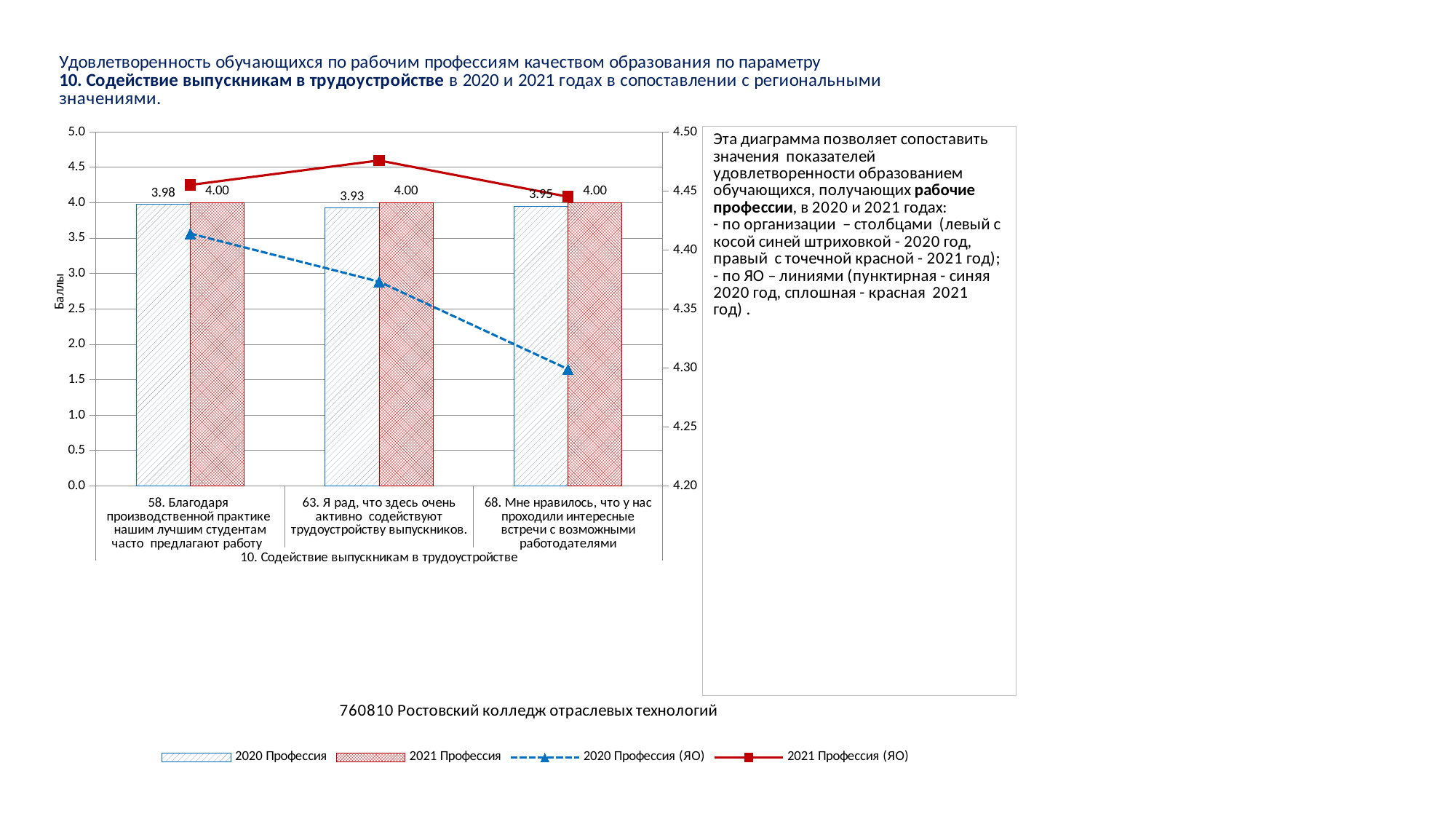
Which category has the lowest 2020 Профессия bar value? 63. Я рад, что здесь очень активно содействуют трудоустройству выпускников. What is the value of the 2021 Профессия bar for category 68 (Мне нравилось, что у нас проходили интересные встречи с возможными работодателями)? 4.00 What is the value of the 2020 Профессия bar for category 63 (Я рад, что здесь очень активно содействуют трудоустройству выпускников)? 3.93 On the right-hand axis, is the 2020 Профессия (ЯО) value for category 68 greater or less than 4.35? less What is the value of the 2020 Профессия bar for category 58 (Благодаря производственной практике нашим лучшим студентам часто предлагают работу)? 3.98 What is the difference between the 2021 Профессия and 2020 Профессия bar values for category 58? 0.02 Does the dashed 2020 Профессия (ЯО) line rise or fall from category 58 to category 68? Falls What is the difference between the 2021 Профессия and 2020 Профессия bar values for category 63? 0.07 Which is larger: the 2020 Профессия bar for category 58 or for category 68? Category 58 (3.98) How many series does the chart legend list? 4 How many categories (questions) are shown on the x axis of the chart? 3 What kind of chart is shown on the slide? Combination bar and line chart